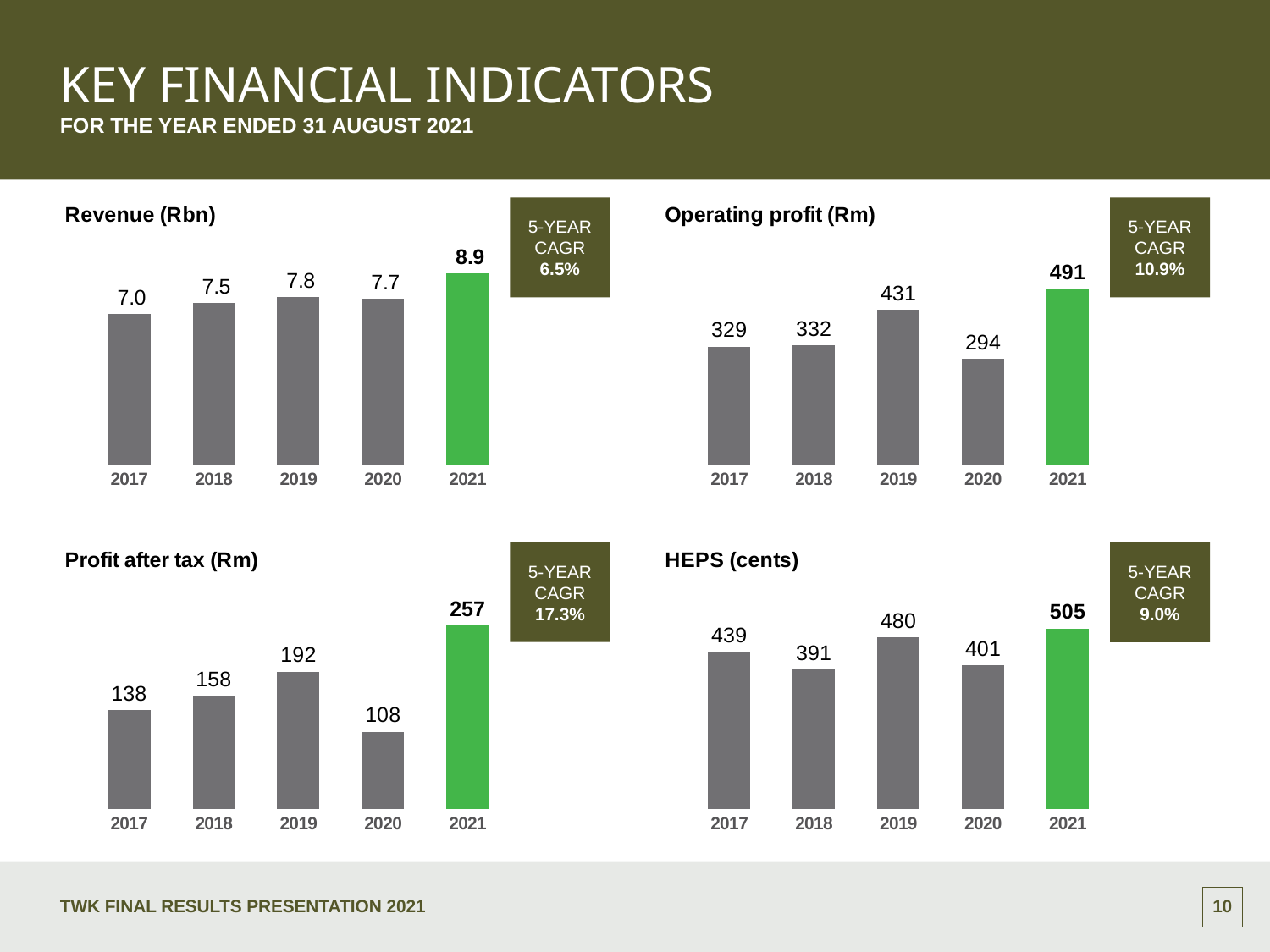
How many years are shown in the Profit after tax (Rm) chart? 5 What 5-year CAGR is shown next to the Profit after tax (Rm) chart? 17.3% In the Revenue (Rbn) chart, which is larger, the value for 2019 or the value for 2020? 2019 In the HEPS (cents) chart, which is larger, the value for 2018 or the value for 2020? 2020 In the Revenue (Rbn) chart, what is the value for 2021? 8.9 What kind of chart is the Revenue (Rbn) chart? Bar chart In the HEPS (cents) chart, what is the value for 2017? 439 In the Profit after tax (Rm) chart, which year has the lowest value? 2020 In the Profit after tax (Rm) chart, what is the difference between the 2019 and 2018 values? 34 In the Operating profit (Rm) chart, what is the value for 2020? 294 In the Operating profit (Rm) chart, what is the difference between the 2021 and 2020 values? 197 In the HEPS (cents) chart, which year has the highest value? 2021